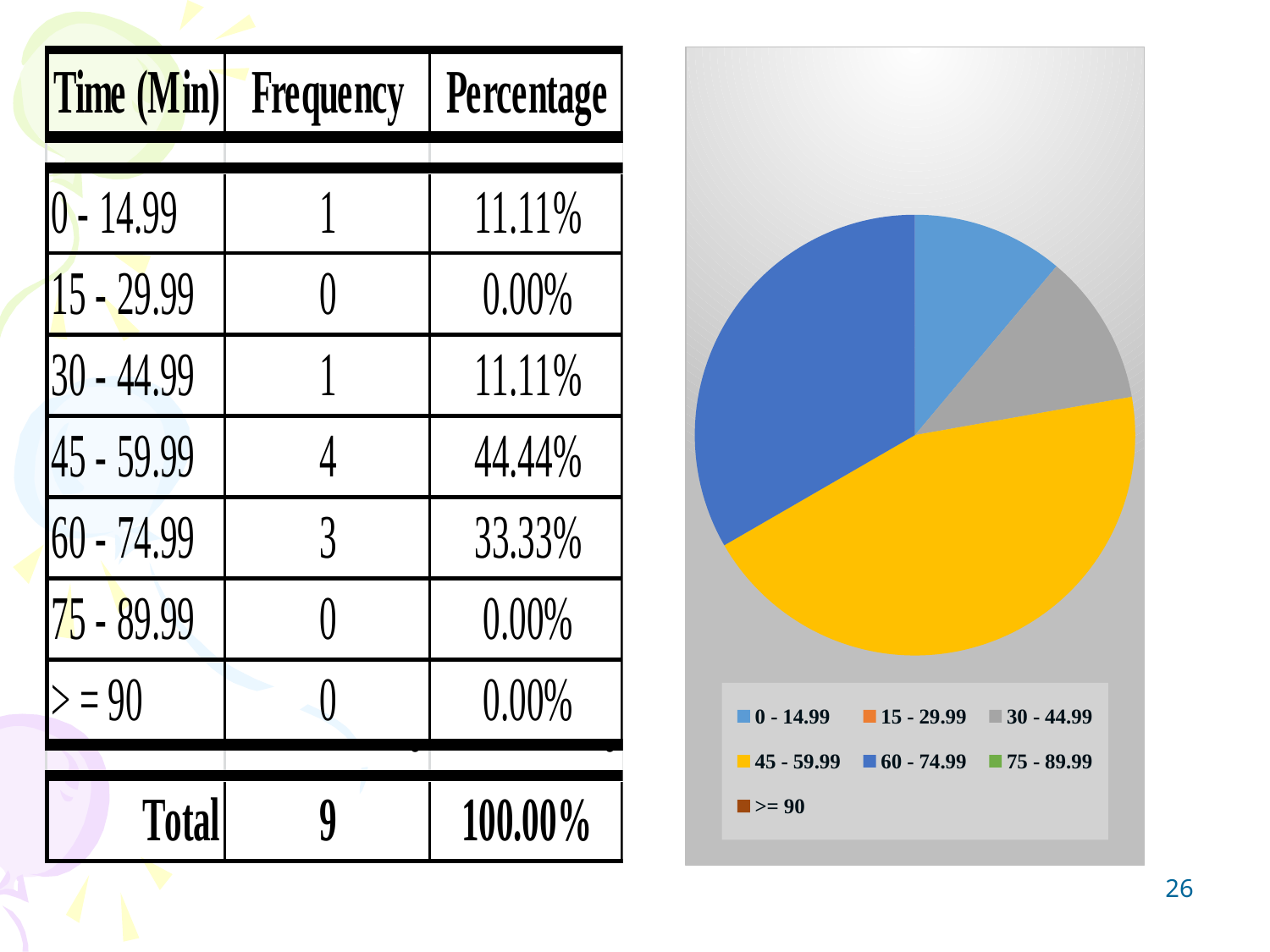
How many time categories have a visible (non-zero) slice in the pie chart? 4 What is the total frequency across all time categories? 9 What is the frequency for the 60 - 74.99 time category? 3 What share of the pie does the 60 - 74.99 category represent? 33.33% What is the difference in frequency between the 45 - 59.99 and 60 - 74.99 categories? 1 What colour is the largest slice of the pie chart? yellow Which time category has the largest slice in the pie chart? 45 - 59.99 What is the frequency for the 45 - 59.99 time category? 4 What share of the pie does the 45 - 59.99 category represent? 44.44% How many entries does the pie chart's legend list? 7 What kind of chart is shown on the right of the slide? pie chart Which slice is larger in the pie chart, 60 - 74.99 or 30 - 44.99? 60 - 74.99